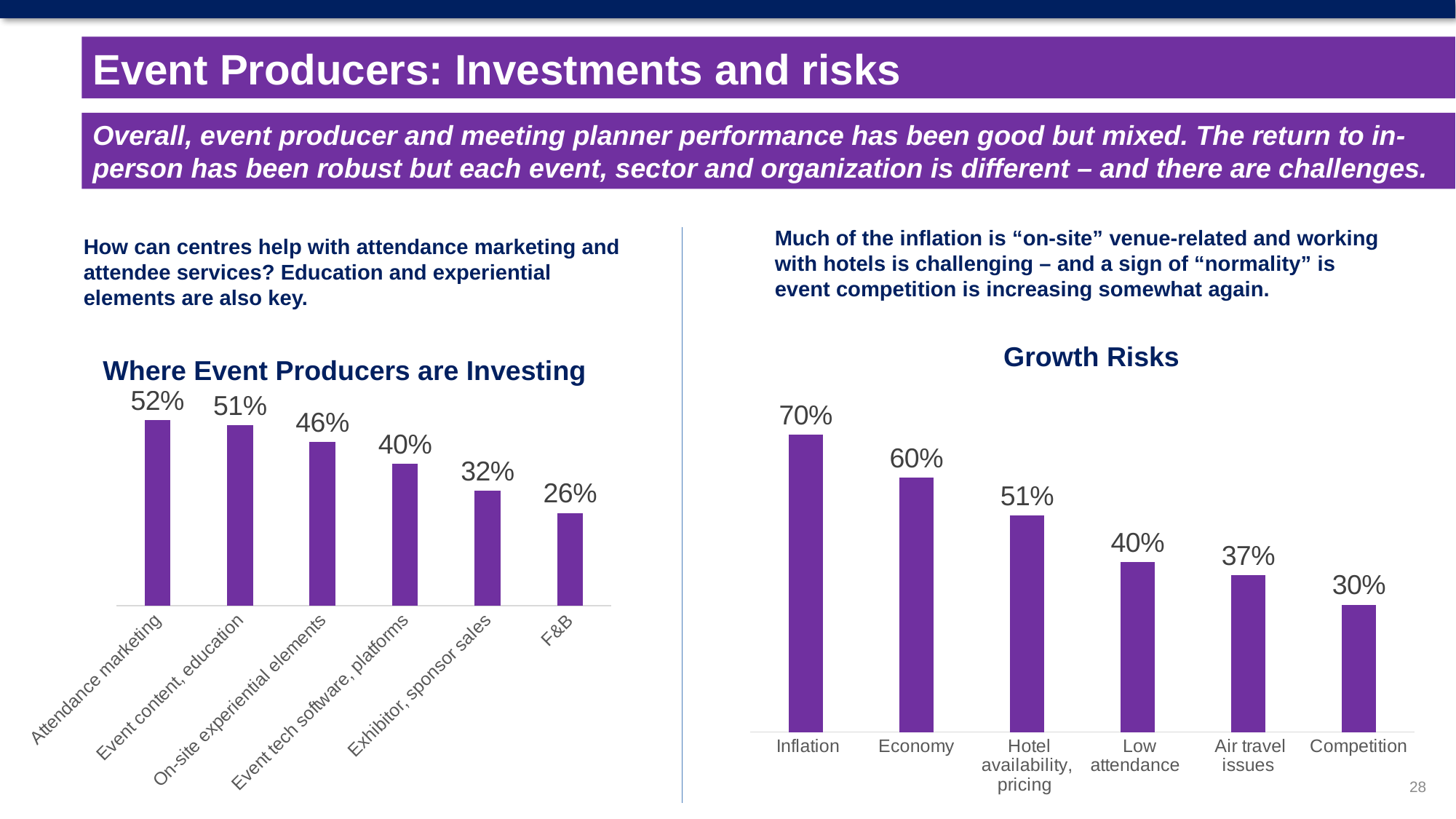
In the 'Growth Risks' chart, what is the difference between Inflation and Competition? 40% In the 'Where Event Producers are Investing' chart, which category has the lowest value? F&B In the 'Where Event Producers are Investing' chart, what is the difference between On-site experiential elements and Exhibitor, sponsor sales? 14% In the 'Growth Risks' chart, which is larger: Hotel availability, pricing or Low attendance? Hotel availability, pricing In the 'Growth Risks' chart, what is the value for Air travel issues? 37% What type of chart is the 'Growth Risks' chart? bar chart In the 'Where Event Producers are Investing' chart, what is the value for Event tech software, platforms? 40% In the 'Where Event Producers are Investing' chart, do the values rise or fall from left to right? fall In the 'Where Event Producers are Investing' chart, what is the value for Attendance marketing? 52% In the 'Growth Risks' chart, which category has the highest value? Inflation In the 'Where Event Producers are Investing' chart, how many categories are shown? 6 In the 'Growth Risks' chart, what is the value for Economy? 60%